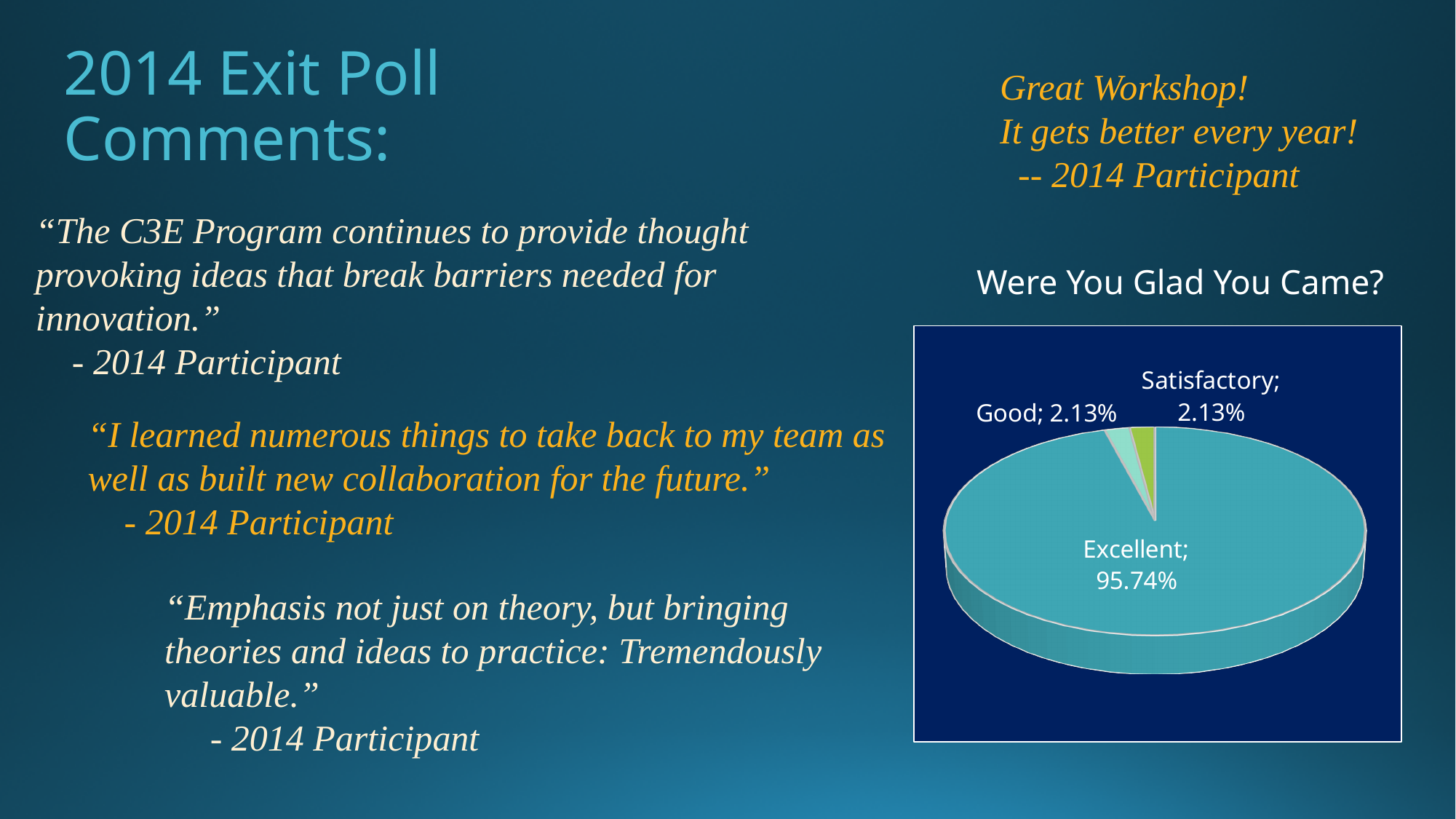
What percentage of respondents answered Excellent? 95.74% Is the share for Excellent greater or less than 90%? greater What kind of chart is shown under "Were You Glad You Came?"? pie chart What is the combined share of the Good and Satisfactory slices? 4.26% What is the title of the chart on the slide? Were You Glad You Came? What percentage of respondents answered Satisfactory? 2.13% What is the difference between the Excellent share and the Good share? 93.61% Which response category has the largest share of the pie? Excellent How many categories are shown in the pie chart? 3 What colour is the Excellent slice of the pie? teal Which is larger, the share for Excellent or the share for Satisfactory? Excellent What percentage of respondents answered Good? 2.13%